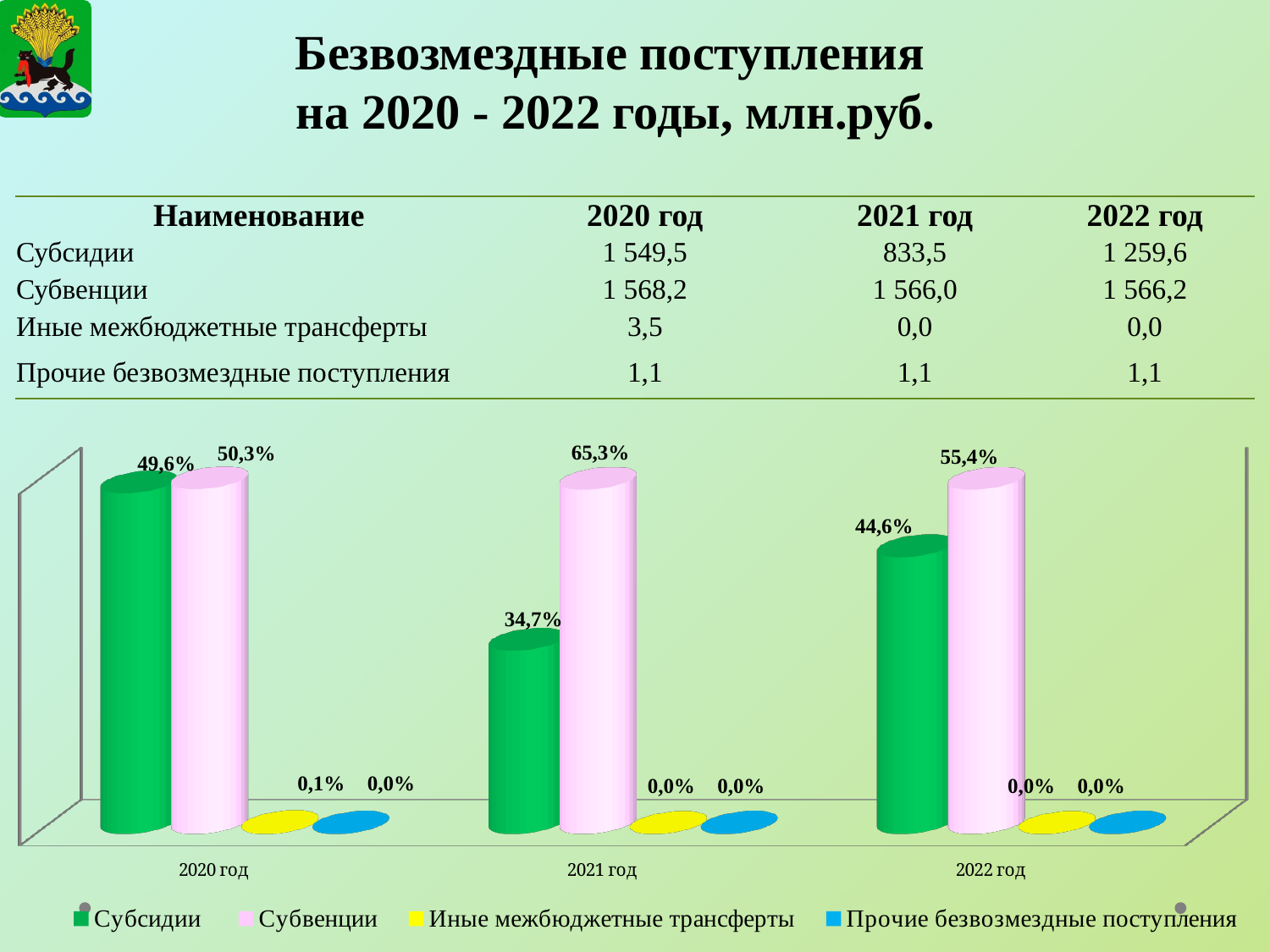
What is the difference between the Субвенции and Субсидии values in 2021 год on the chart? 30,6% What is the value for Субсидии in 2020 год on the chart? 49,6% What is the value for Иные межбюджетные трансферты in 2020 год on the chart? 0,1% In which year is the value for Субсидии the lowest on the chart? 2021 год How many year categories are shown on the x axis of the chart? 3 Which is larger in 2022 год on the chart, Субсидии or Субвенции? Субвенции What is the value for Субсидии in 2022 год on the chart? 44,6% What type of chart is shown on the slide? bar chart Which colour represents Субвенции in the chart legend? pink How many series does the chart legend list? 4 What is the value for Субвенции in 2021 год on the chart? 65,3%